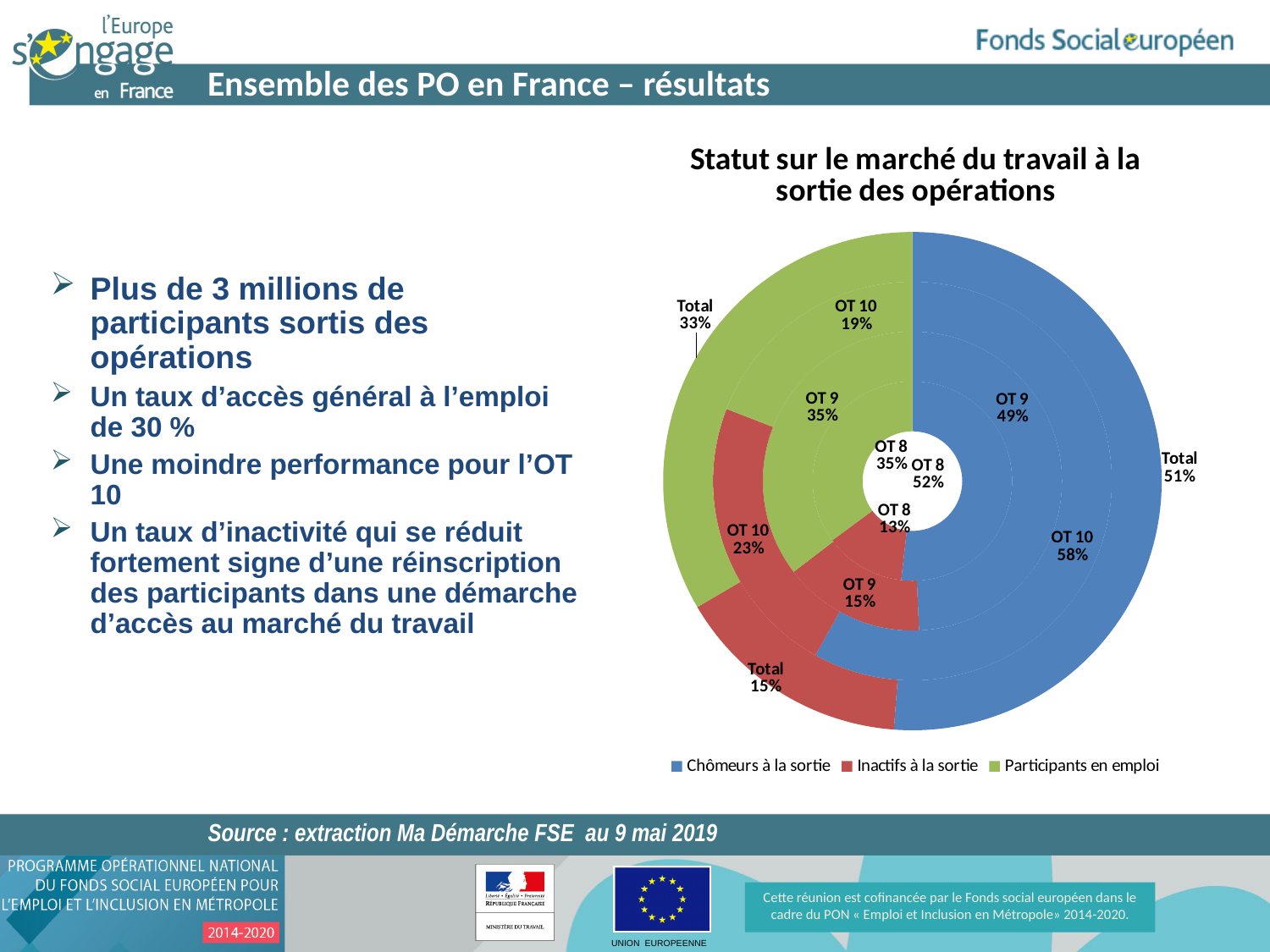
Which category (OT 8, OT 9, OT 10 or Total) has the lowest share of 'Participants en emploi'? OT 10 What kind of chart is shown on the slide? Doughnut chart What is the difference between the 'Inactifs à la sortie' share for OT 10 and for OT 9? 8% What is the share of 'Participants en emploi' for the Total ring? 33% What is the share of 'Chômeurs à la sortie' for OT 10? 58% Which colour represents 'Participants en emploi' in the chart? Green Which is larger: the 'Chômeurs à la sortie' share for OT 8 or for OT 9? OT 8 What is the title of the chart? Statut sur le marché du travail à la sortie des opérations How many series does the chart legend list? 3 What is the share of 'Inactifs à la sortie' for OT 8? 13% How many rings (categories) does the doughnut chart show? 4 Which category (OT 8, OT 9, OT 10 or Total) has the highest share of 'Chômeurs à la sortie'? OT 10